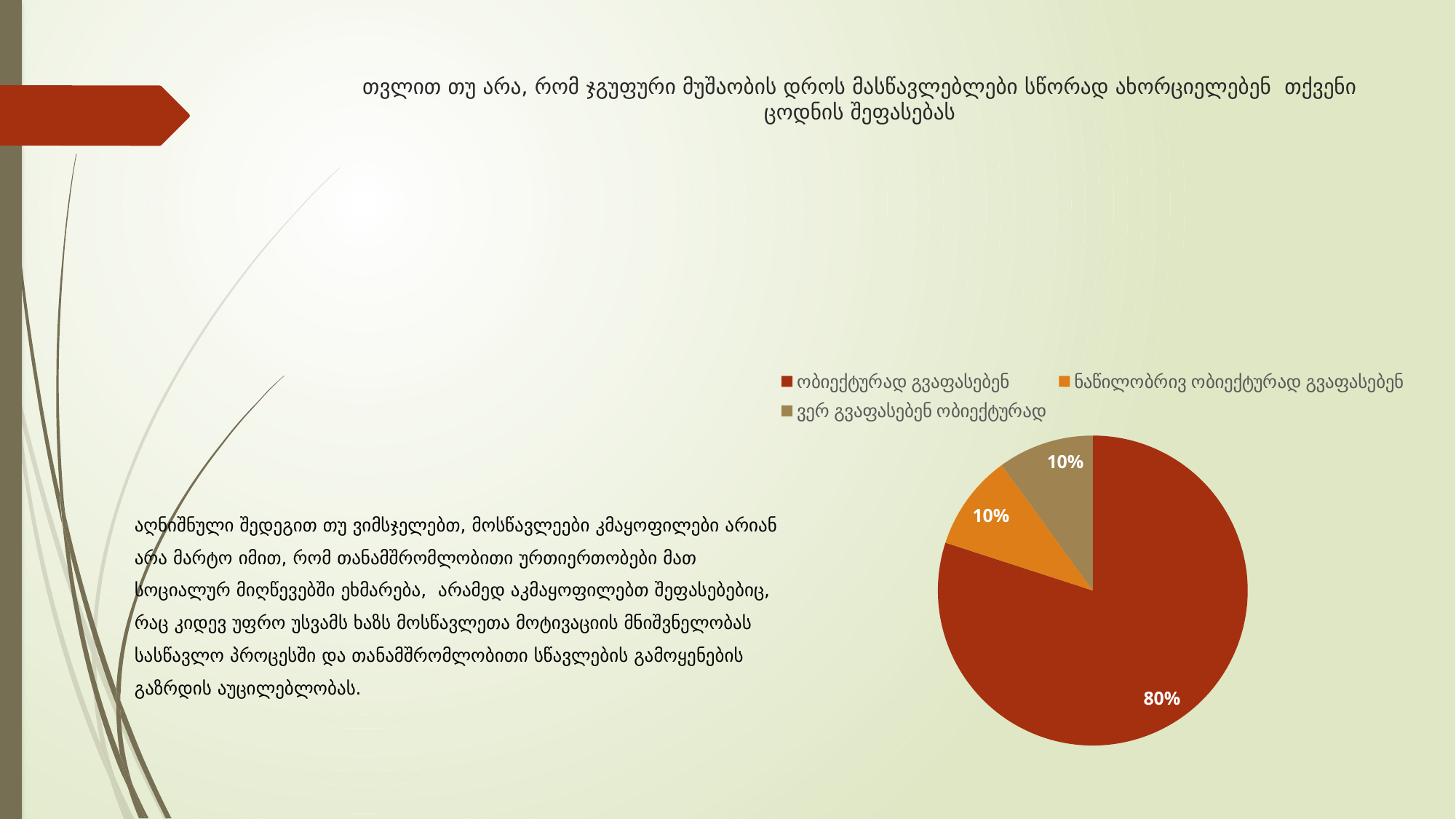
Which category has the largest slice of the pie? ობიექტურად გვაფასებენ What is the difference in percentage points between "ობიექტურად გვაფასებენ" and "ვერ გვაფასებენ ობიექტურად"? 70 What percentage of the pie is labelled "ვერ გვაფასებენ ობიექტურად"? 10% Which is larger: the slice for "ობიექტურად გვაფასებენ" or the slice for "ნაწილობრივ ობიექტურად გვაფასებენ"? ობიექტურად გვაფასებენ What percentage of the pie is labelled "ნაწილობრივ ობიექტურად გვაფასებენ"? 10% What colour is the largest slice of the pie? dark red How many slices does the pie chart have? 3 How many entries does the legend list? 3 What percentage of the pie is labelled "ობიექტურად გვაფასებენ"? 80% What kind of chart is shown on the slide? pie chart What colour is the slice for "ნაწილობრივ ობიექტურად გვაფასებენ"? orange What share of the pie does the "ობიექტურად გვაფასებენ" slice take? 80%